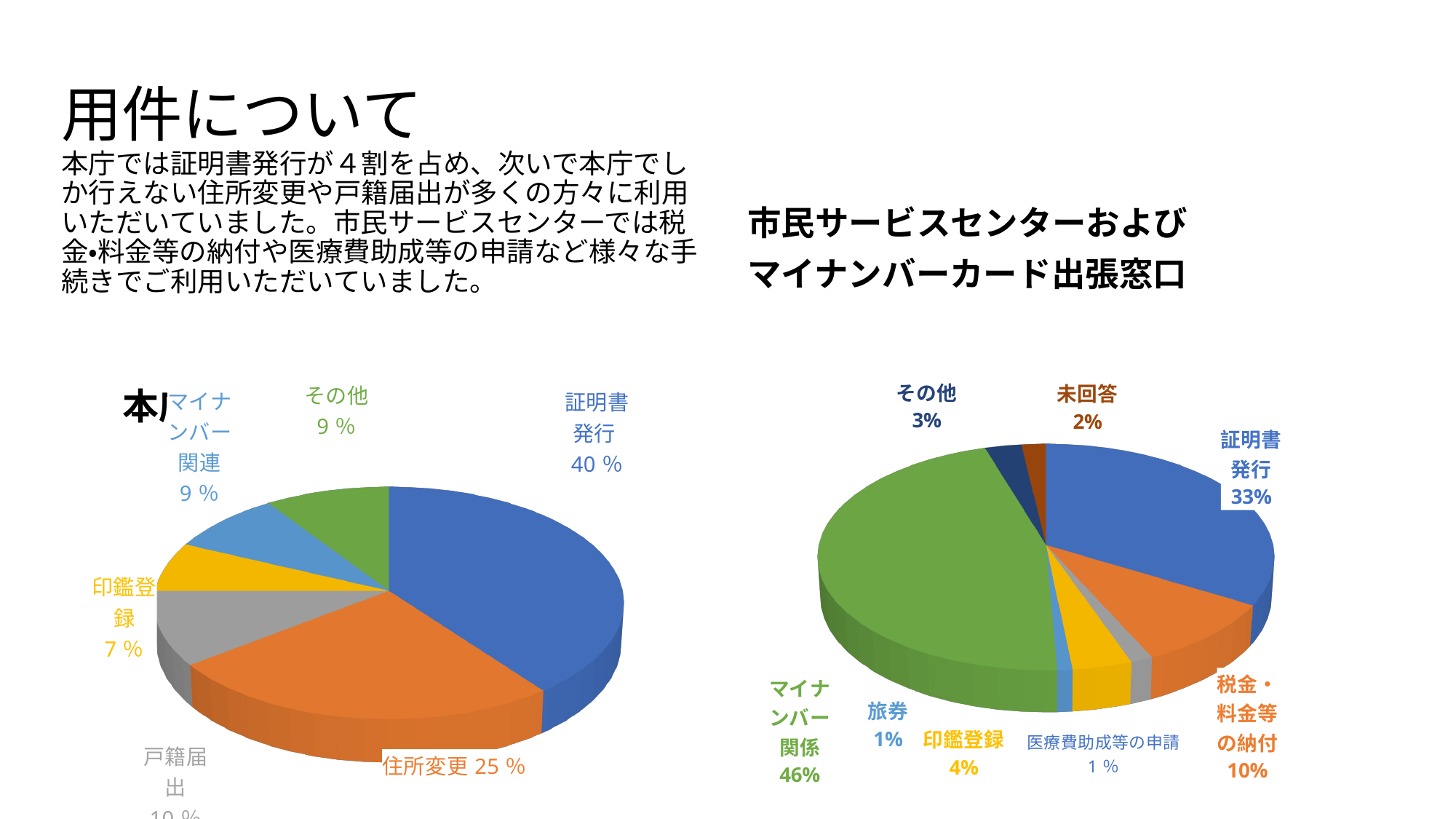
In the right pie chart (市民サービスセンターおよびマイナンバーカード出張窓口), which is larger, 証明書発行 or 税金・料金等の納付? 証明書発行 In the right pie chart (市民サービスセンターおよびマイナンバーカード出張窓口), which category has the largest share? マイナンバー関係 In the right pie chart (市民サービスセンターおよびマイナンバーカード出張窓口), what share does マイナンバー関係 have? 46% In the left pie chart, what share does 住所変更 have? 25 % In the right pie chart (市民サービスセンターおよびマイナンバーカード出張窓口), what share does 税金・料金等の納付 have? 10% In the right pie chart (市民サービスセンターおよびマイナンバーカード出張窓口), how many categories are shown? 8 In the left pie chart, what share does 印鑑登録 have? 7 % In the left pie chart, what is the difference between the shares of 証明書発行 and 住所変更? 15 % In the left pie chart, which category has the largest share? 証明書発行 In the right pie chart (市民サービスセンターおよびマイナンバーカード出張窓口), what is the difference between the shares of マイナンバー関係 and 証明書発行? 13% What kind of chart is the right chart (市民サービスセンターおよびマイナンバーカード出張窓口)? Pie chart In the left pie chart, what share does 証明書発行 have? 40 %